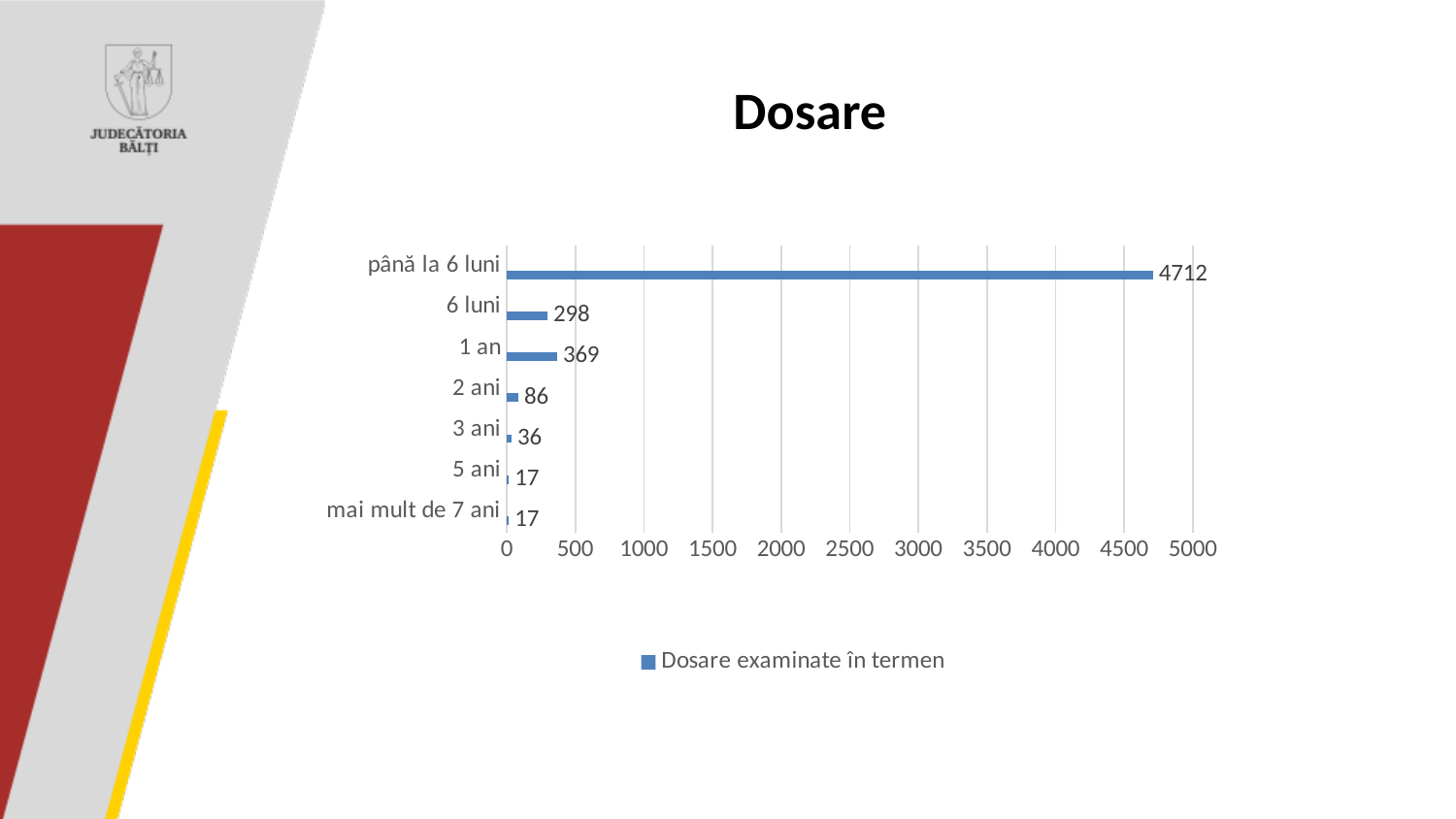
How many categories are shown in the chart? 7 Is the value for "până la 6 luni" greater or less than 4500? greater What is the value for "2 ani"? 86 What is the value for "1 an"? 369 What kind of chart is shown on the slide? bar chart How many series does the legend list? 1 What is the legend entry of the chart? Dosare examinate în termen Which category has the highest value? până la 6 luni What is the value for "până la 6 luni"? 4712 What is the title of the chart? Dosare Which is larger, the value for "6 luni" or the value for "1 an"? 1 an What is the difference between the values for "1 an" and "6 luni"? 71